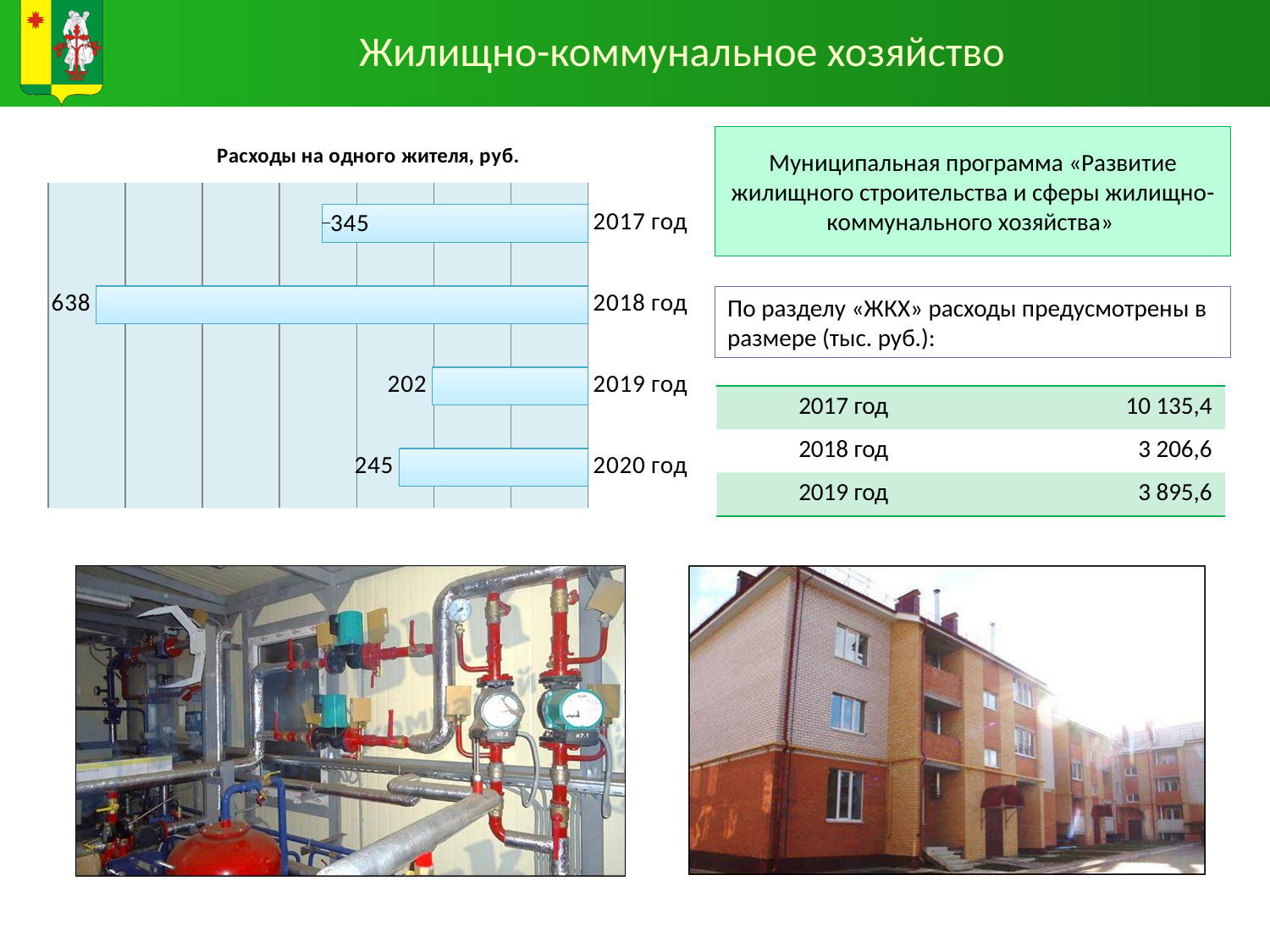
Which year has the highest value in the chart? 2018 год What is the value for 2019 год in the chart? 202 What is the value for 2018 год in the chart? 638 Which is larger, the value for 2020 год or the value for 2019 год? 2020 год What type of chart is shown on the slide? bar chart What is the value for 2020 год in the chart? 245 How many categories (years) are plotted in the chart? 4 What is the value for 2017 год in the chart? 345 What is the title of the chart? Расходы на одного жителя, руб. Which year has the lowest value in the chart? 2019 год What is the difference between the values for 2018 год and 2017 год? 293 Does the value rise or fall from 2018 год to 2019 год? fall